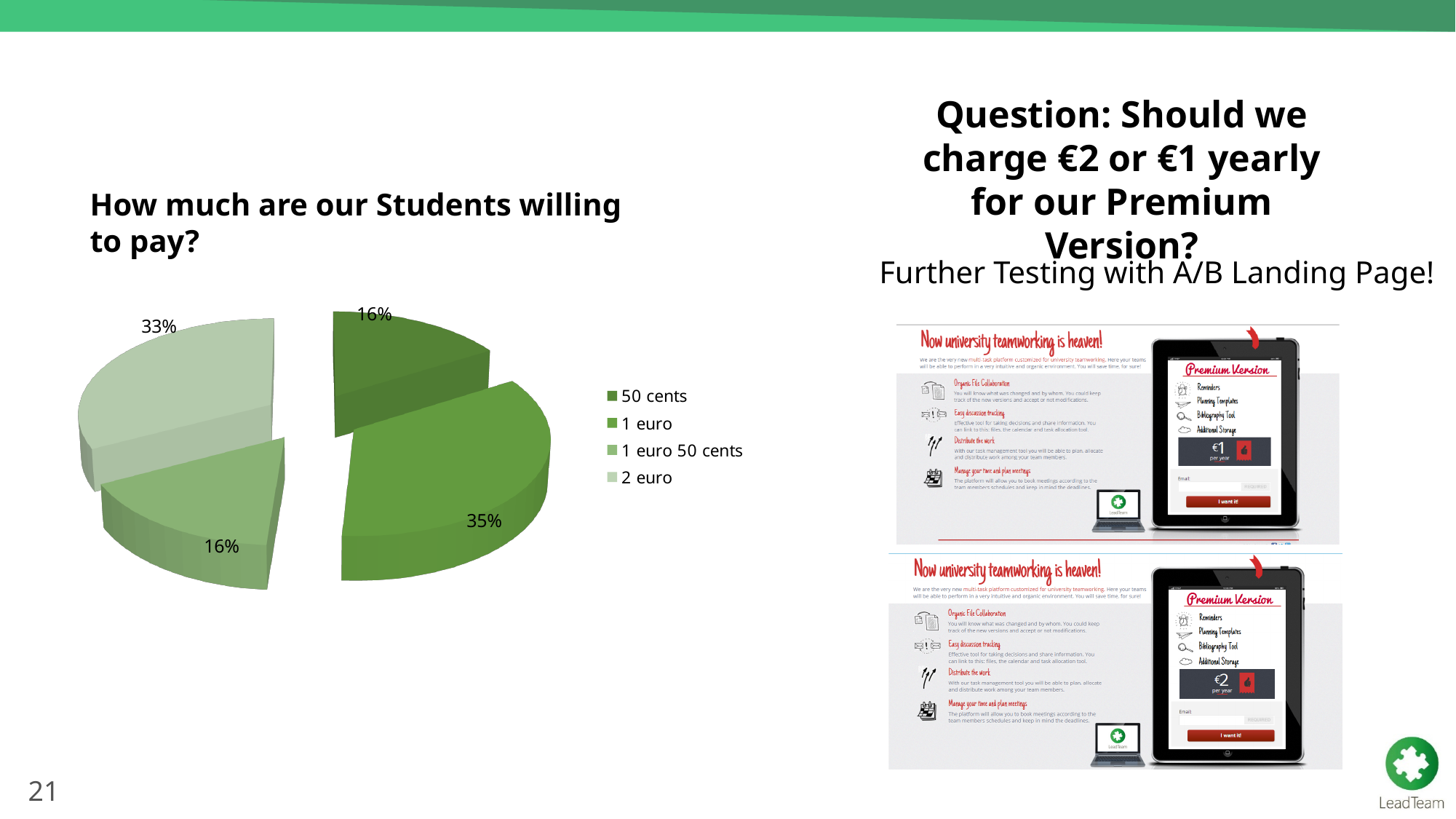
What is the difference in percentage points between the 2 euro slice and the 1 euro 50 cents slice? 17 percentage points What is the title of the chart? How much are our Students willing to pay? What is the difference in percentage points between the 1 euro slice and the 2 euro slice? 2 percentage points What share of students are willing to pay 50 cents? 16% Which slice is larger: 2 euro or 50 cents? 2 euro What share of students are willing to pay 2 euro? 33% How many slices does the pie chart have? 4 What share of students are willing to pay 1 euro? 35% How many entries does the chart legend list? 4 What type of chart is shown on the slide? Pie chart Which price option has the largest share of the pie? 1 euro